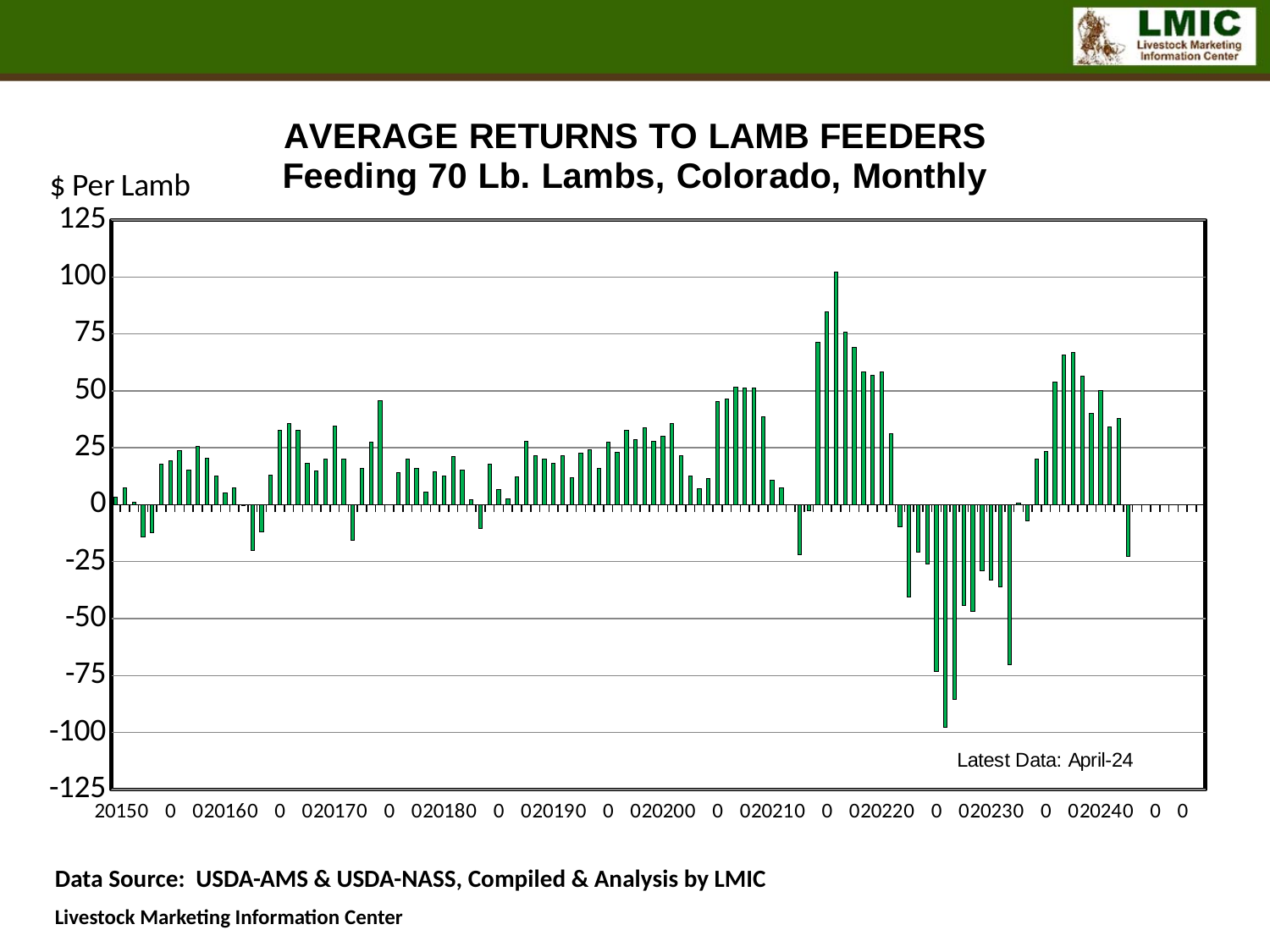
In which year does the lowest bar on the chart occur? 2022 In which year does the highest bar on the chart occur? 2021 Which is taller: the tallest bar in 2021 or the tallest bar in 2024? 2021 Is the final bar (April-24) greater or less than 0? less What kind of chart is shown on the slide? Bar chart What is the title of the chart? AVERAGE RETURNS TO LAMB FEEDERS Feeding 70 Lb. Lambs, Colorado, Monthly Is the highest bar on the chart greater or less than 75 $ per lamb? greater According to the note on the chart, what is the latest data month? April-24 Do the values rise or fall from the 2021 peak into 2022? fall Is the lowest bar on the chart greater or less than -75 $ per lamb? less